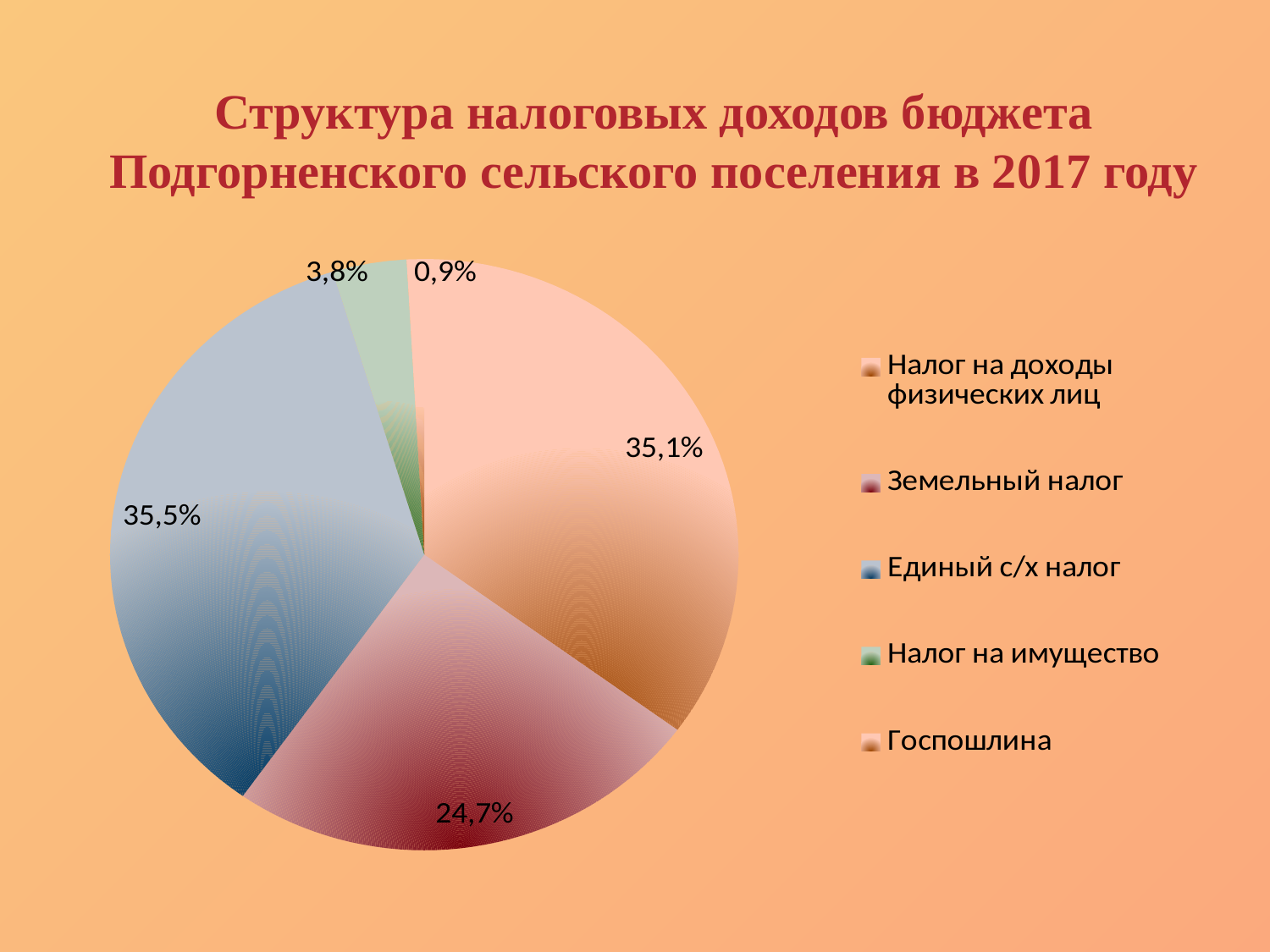
What type of chart is shown on the slide? pie chart Which category has the largest share of the pie? Единый с/х налог What share of tax revenue does Госпошлина account for? 0,9% What share of tax revenue does Единый с/х налог account for? 35,5% Which category has the smallest share of the pie? Госпошлина How many categories does the pie chart show? 5 What share of tax revenue does Земельный налог account for? 24,7% What is the title of the slide? Структура налоговых доходов бюджета Подгорненского сельского поселения в 2017 году What is the difference between the shares of Налог на доходы физических лиц and Земельный налог? 10,4% What share of tax revenue does Налог на имущество account for? 3,8% Which is larger: the share of Земельный налог or the share of Налог на имущество? Земельный налог What share of tax revenue does Налог на доходы физических лиц account for? 35,1%